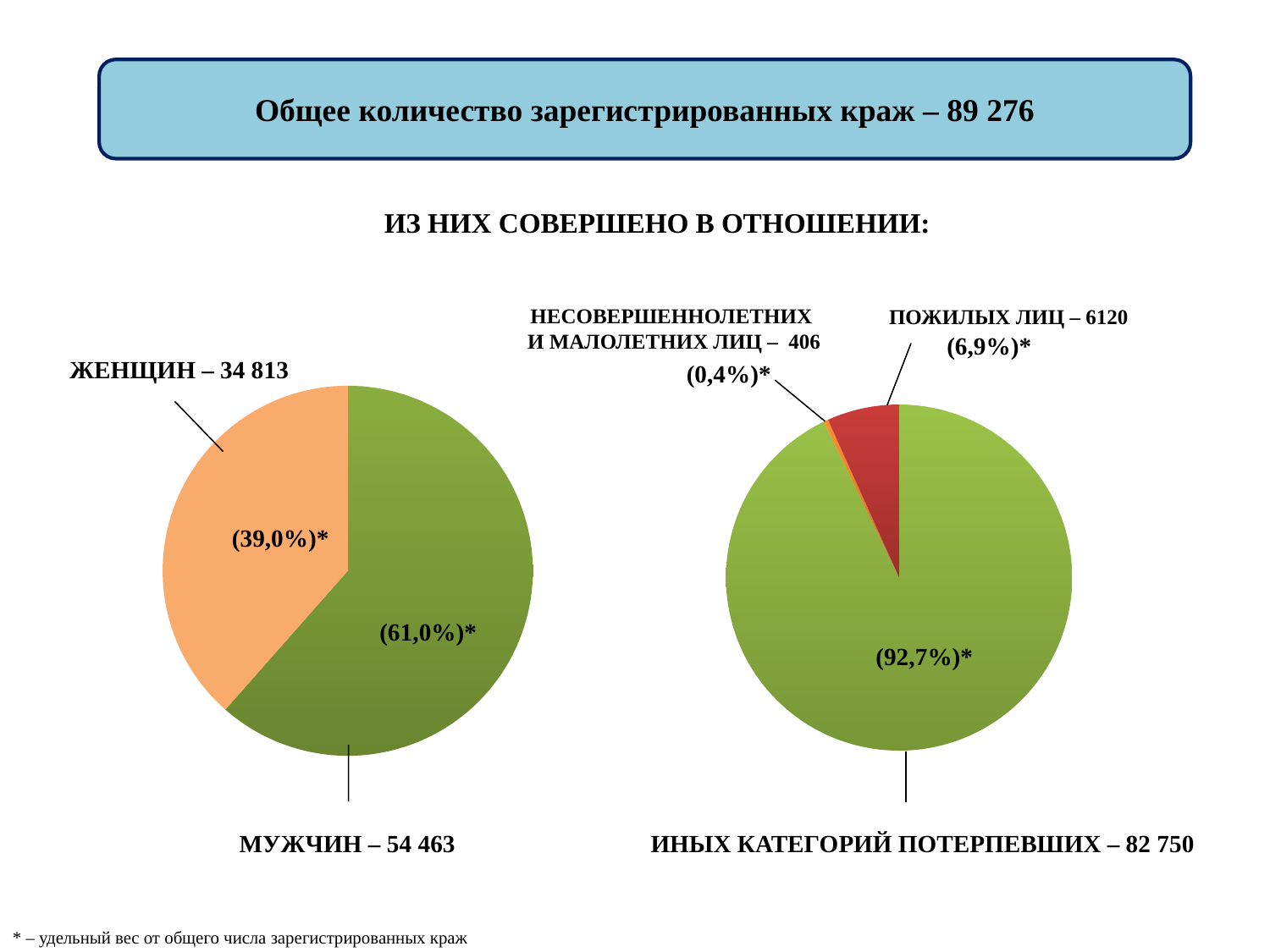
In the right pie chart, what is the value for НЕСОВЕРШЕННОЛЕТНИХ И МАЛОЛЕТНИХ ЛИЦ? 406 What total number of registered thefts is stated in the box at the top of the slide? 89 276 In the right pie chart, what is the value for ПОЖИЛЫХ ЛИЦ? 6120 In the left pie chart, what is the value for МУЖЧИН? 54 463 In the left pie chart, what share of the pie does ЖЕНЩИН take? 39,0% In the left pie chart, what is the difference between the values for МУЖЧИН and ЖЕНЩИН? 19 650 In the right pie chart, what share of the pie does ИНЫХ КАТЕГОРИЙ ПОТЕРПЕВШИХ take? 92,7% In the left pie chart, what is the value for ЖЕНЩИН? 34 813 What kind of chart is the left chart on the slide? pie chart In the left pie chart, which slice is larger, ЖЕНЩИН or МУЖЧИН? МУЖЧИН How many slices does the right pie chart have? 3 In the right pie chart, which category has the smallest slice? НЕСОВЕРШЕННОЛЕТНИХ И МАЛОЛЕТНИХ ЛИЦ